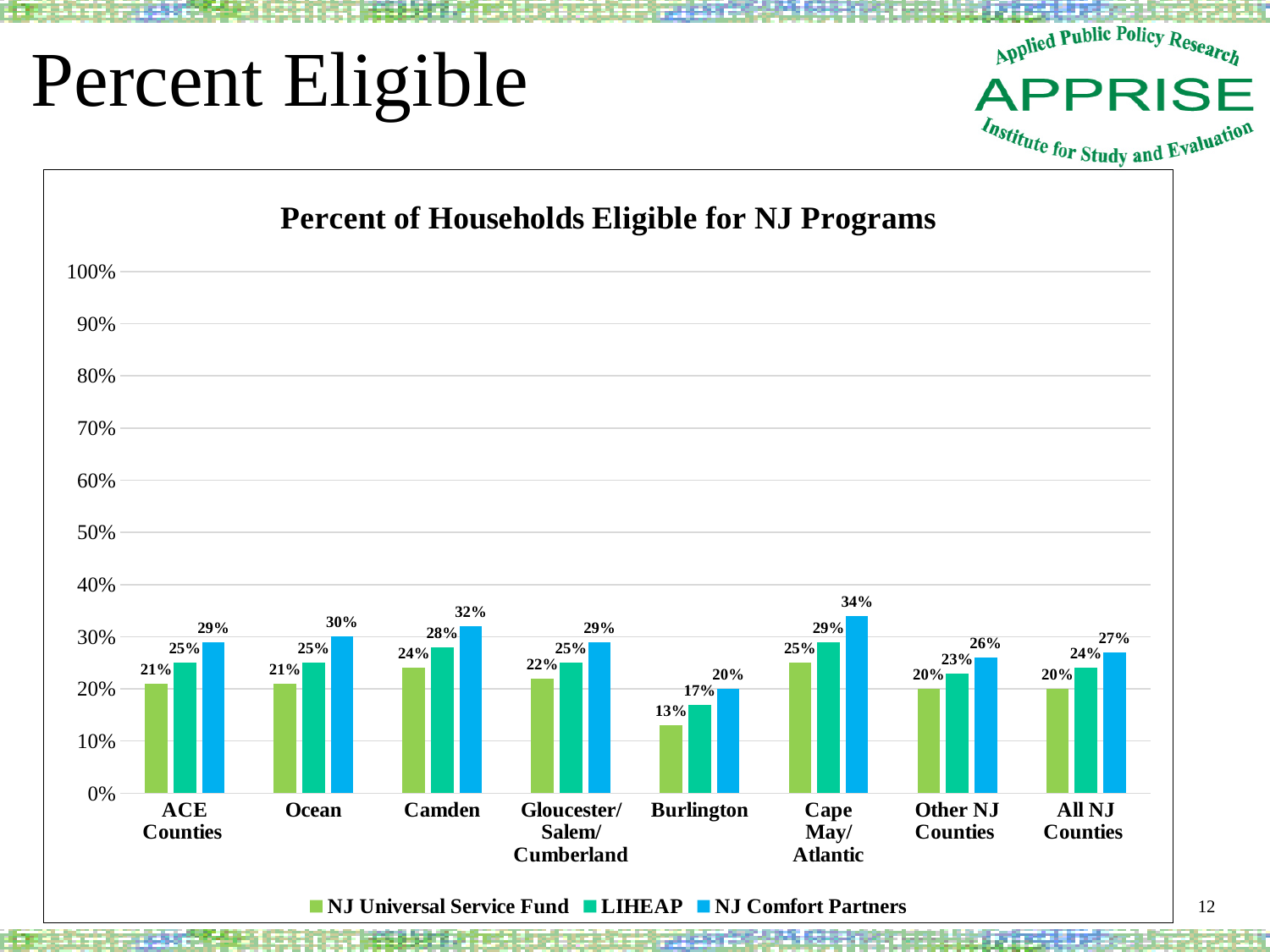
What is the NJ Comfort Partners value for Cape May/Atlantic? 34% What kind of chart is shown? bar chart Which is larger: the LIHEAP value for Ocean or the LIHEAP value for Cape May/Atlantic? Cape May/Atlantic Is the NJ Comfort Partners value for Burlington greater or less than 30%? less Which category has the highest NJ Comfort Partners value? Cape May/Atlantic How many series does the legend list? 3 What is the LIHEAP value for Camden? 28% Which category has the lowest LIHEAP value? Burlington What is the difference between the NJ Comfort Partners and NJ Universal Service Fund values for Camden? 8% How many categories are shown on the x axis? 8 What is the NJ Universal Service Fund value for Burlington? 13% What is the title of the chart? Percent of Households Eligible for NJ Programs